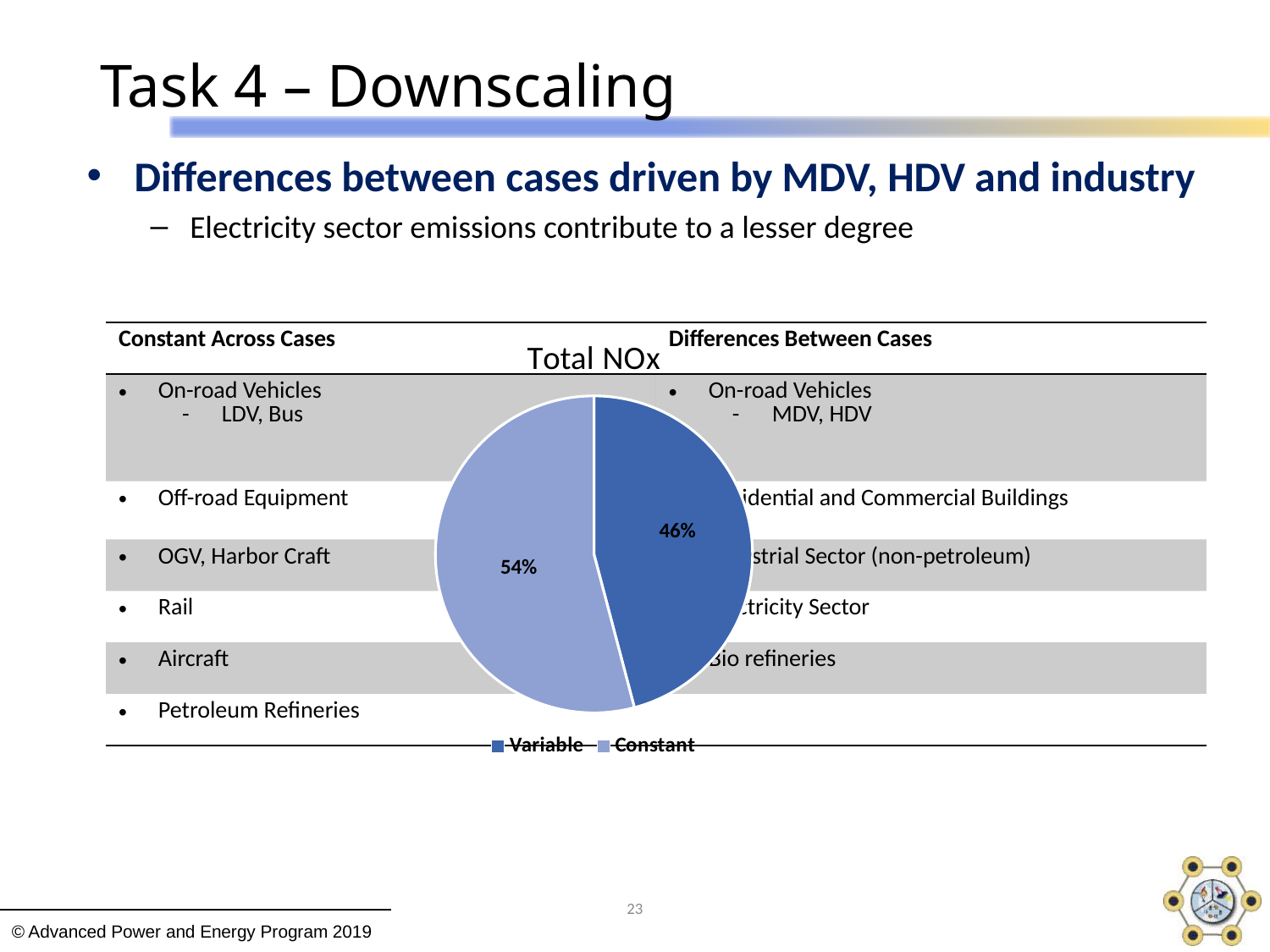
What kind of chart is shown on the slide? pie chart Is the Variable share greater or less than 50%? less How many entries does the legend list? 2 What share of Total NOx is labelled Variable? 46% What is the title of the chart? Total NOx Which legend entry is shown in the darker blue colour? Variable How many slices does the pie chart have? 2 Which slice of the pie is larger, Variable or Constant? Constant What is the difference in percentage points between the Constant and Variable slices? 8 Which category has the smallest share of the pie? Variable Which category has the largest share of the pie? Constant What share of Total NOx is labelled Constant? 54%